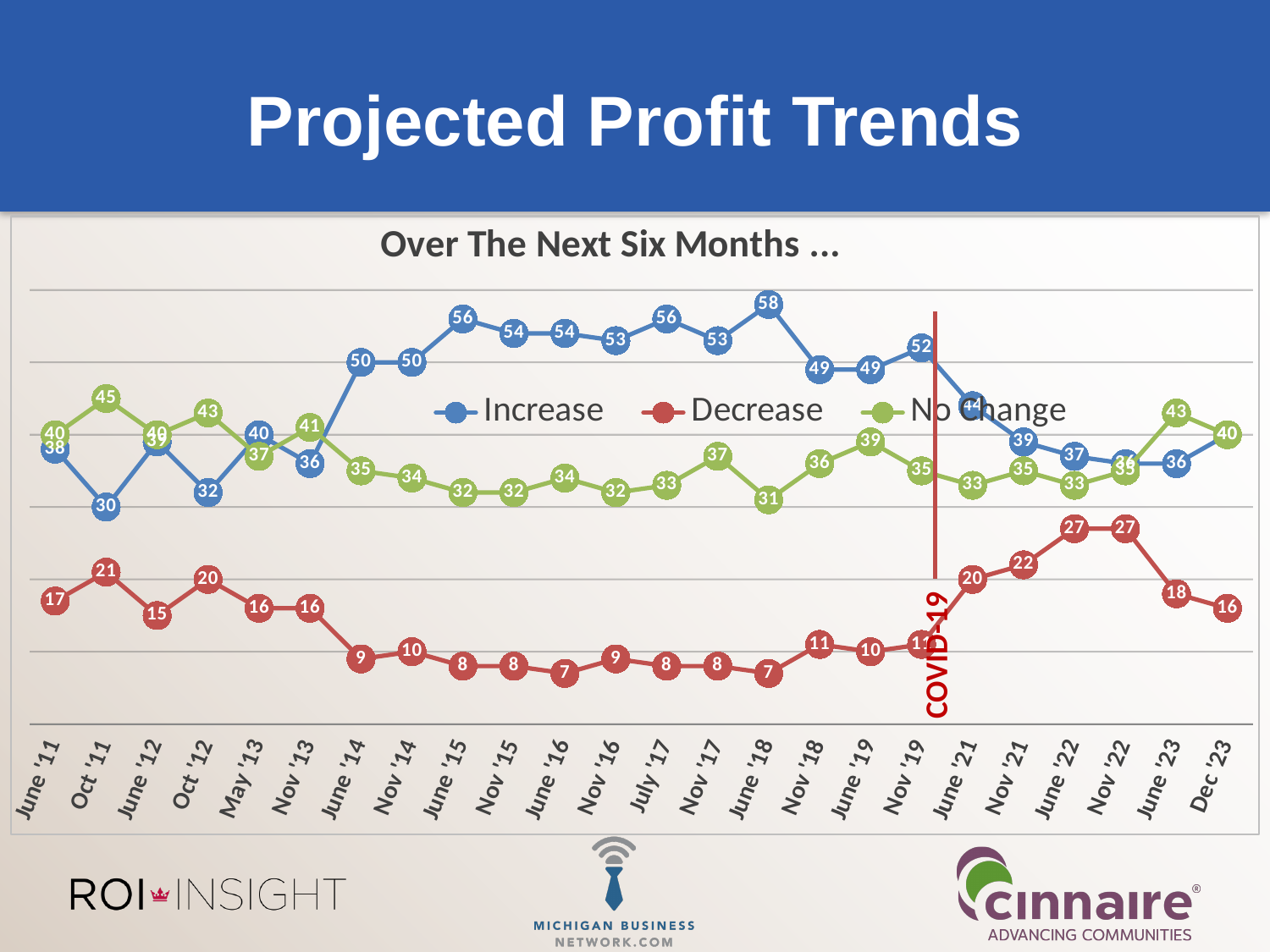
What event does the vertical red line on the chart mark? COVID-19 How many time points are plotted along the x axis? 24 What kind of chart is shown on the slide? line chart What is the lowest value of the Increase series? 30 What is the Increase value for June '15? 56 At which time point does the No Change series reach its highest value? Oct '11 At Nov '21, which is larger: the Increase value or the No Change value? Increase How many series does the legend list? 3 What is the difference between the Increase and Decrease values at June '18? 51 What is the Decrease value for Dec '23? 16 At which time point does the Increase series reach its highest value? June '18 What is the No Change value for Nov '17? 37